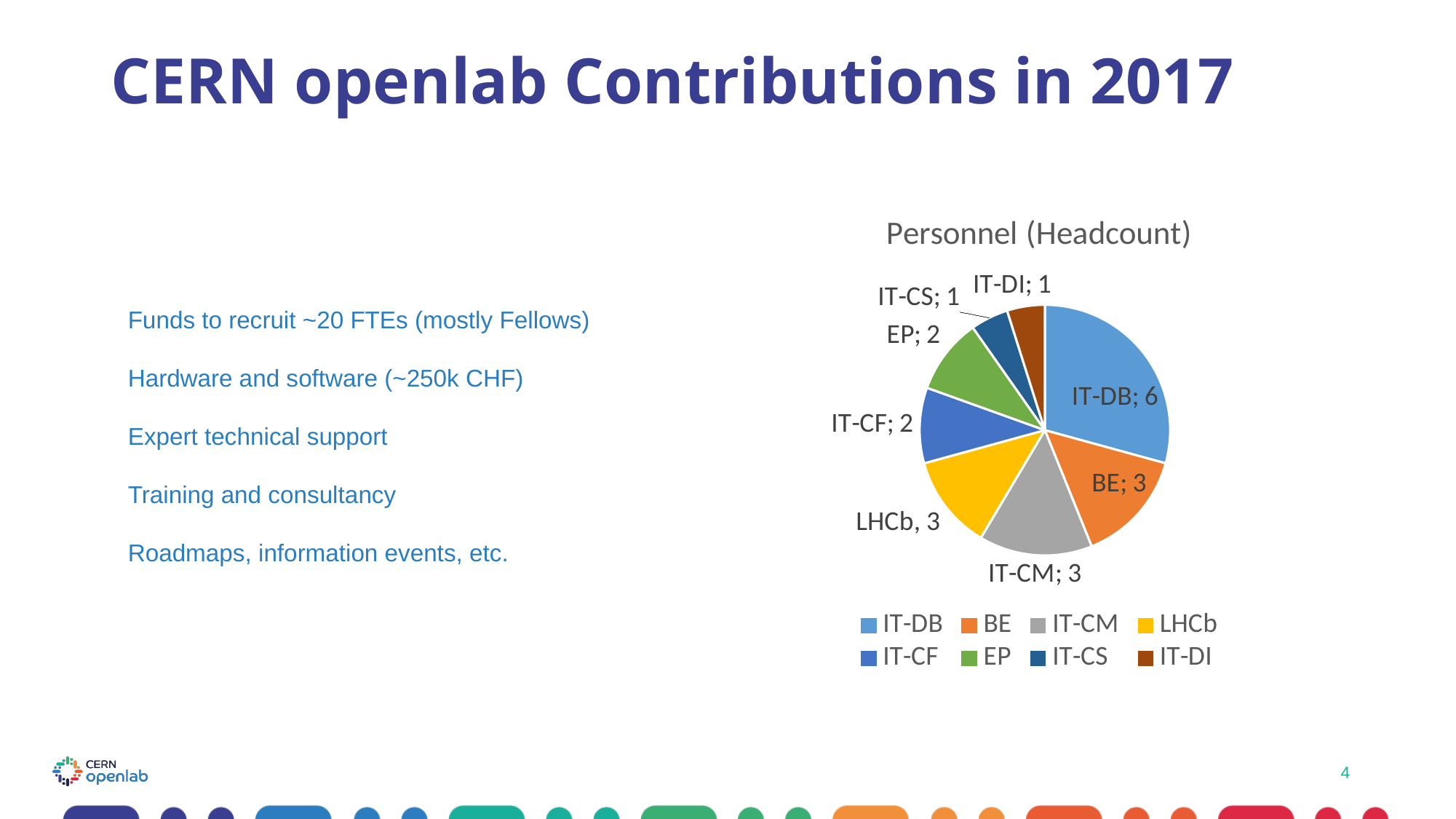
What is the title of the chart on the slide? Personnel (Headcount) What is the headcount for IT-DI? 1 What is the total headcount across all slices of the pie chart? 21 What is the difference in headcount between IT-DB and BE? 3 Which has a larger headcount, EP or IT-CM? IT-CM Which two categories have the smallest headcount in the pie chart? IT-CS and IT-DI What is the headcount for LHCb? 3 What is the headcount for IT-CF? 2 What is the headcount for IT-DB in the Personnel (Headcount) chart? 6 What kind of chart is used to show Personnel (Headcount)? Pie chart How many categories are shown in the Personnel (Headcount) pie chart? 8 Which category has the largest headcount in the pie chart? IT-DB